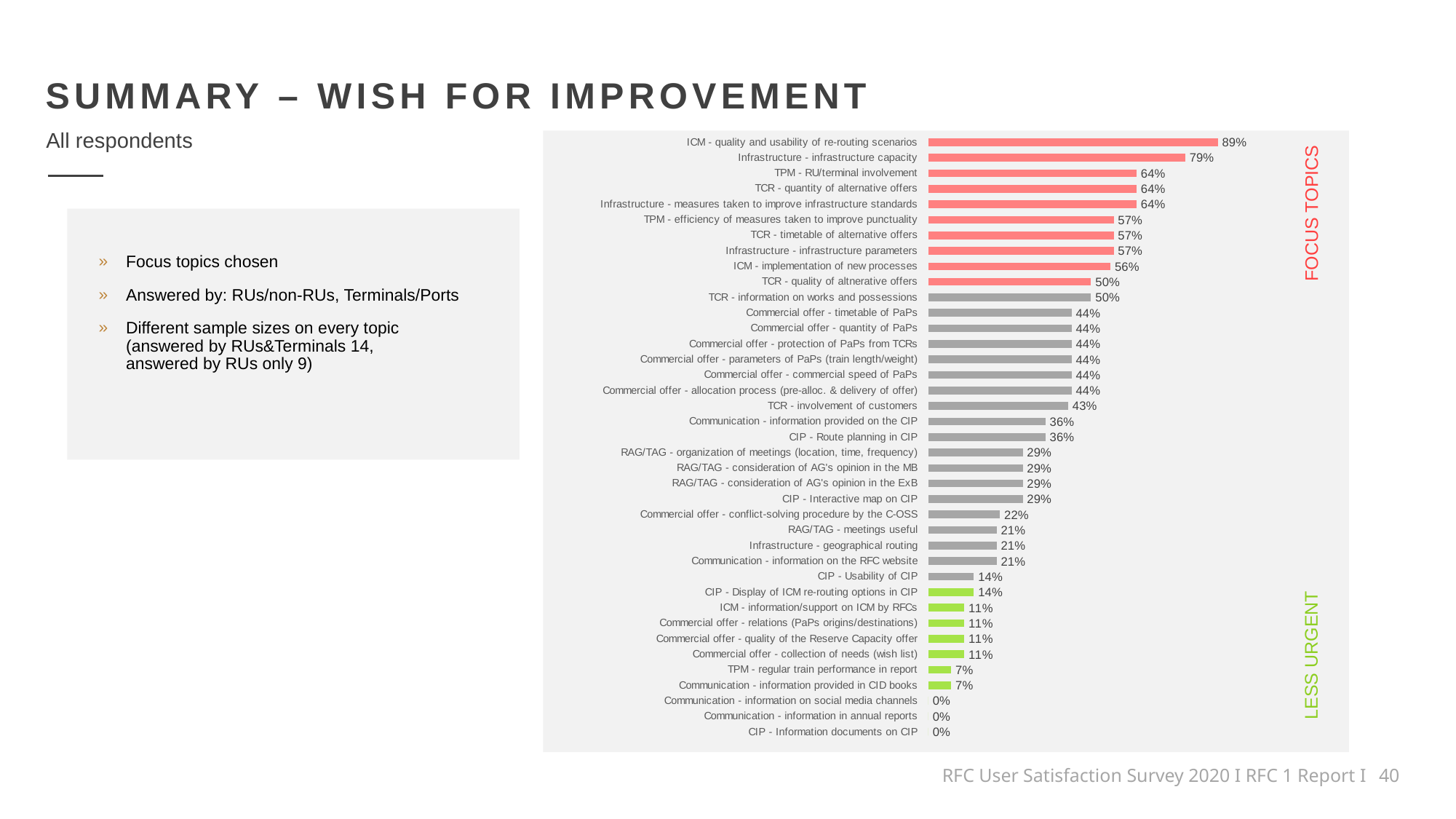
What is the value for 'ICM - quality and usability of re-routing scenarios'? 89% What label is written vertically next to the red bars at the top of the chart? FOCUS TOPICS What is the value for 'Commercial offer - conflict-solving procedure by the C-OSS'? 22% What kind of chart is shown on the slide? Bar chart What is the value for 'TCR - involvement of customers'? 43% Which category has the highest value? ICM - quality and usability of re-routing scenarios Which is larger, 'CIP - Route planning in CIP' or 'CIP - Interactive map on CIP'? CIP - Route planning in CIP What is the difference between 'TPM - RU/terminal involvement' and 'ICM - implementation of new processes'? 8% How many categories are plotted in the chart? 39 What is the value for 'Infrastructure - infrastructure capacity'? 79% Which is larger, 'TPM - regular train performance in report' or 'CIP - Usability of CIP'? CIP - Usability of CIP What is the difference between 'ICM - quality and usability of re-routing scenarios' and 'Infrastructure - infrastructure capacity'? 10%